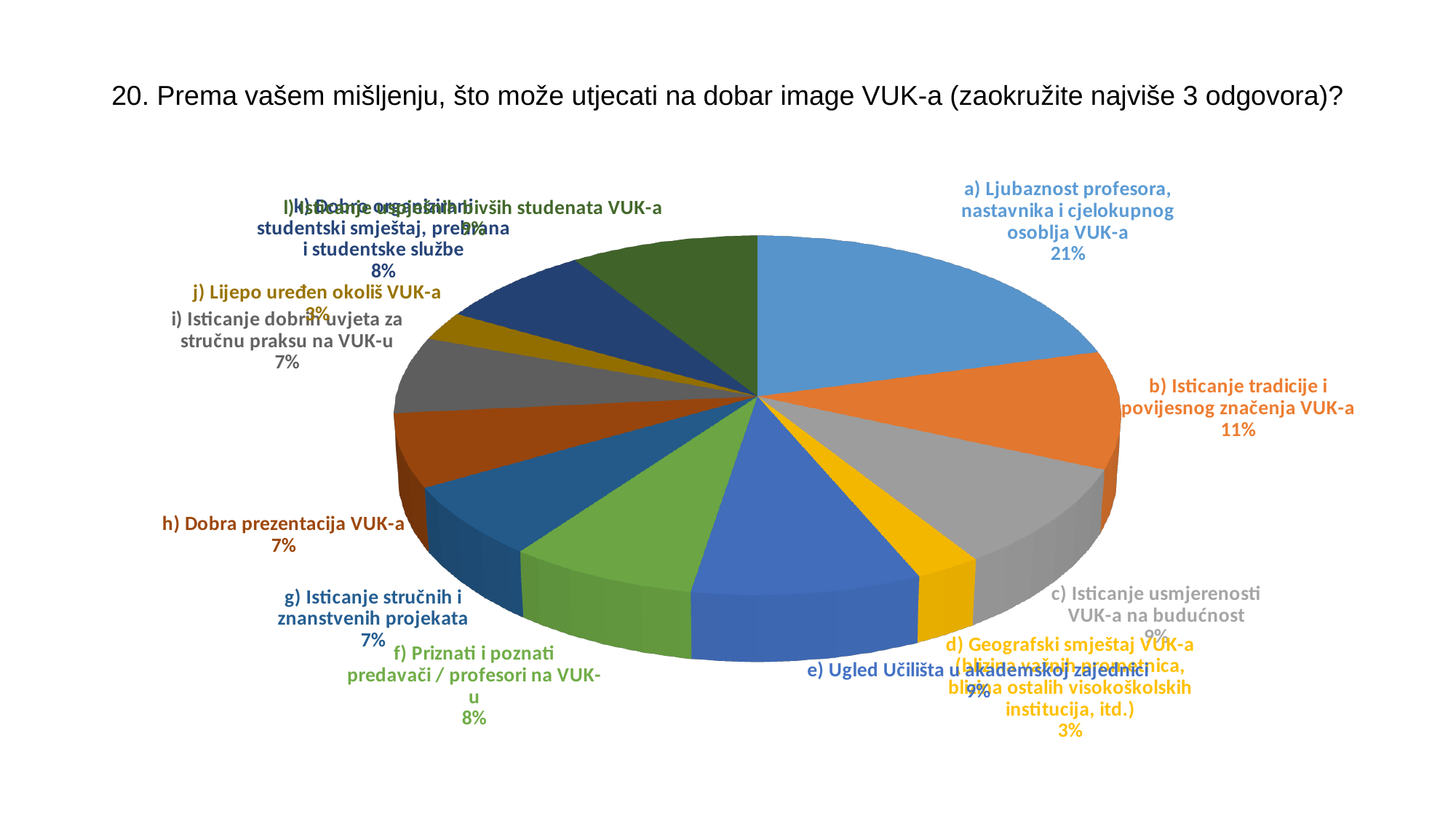
What is the value for "c) Isticanje usmjerenosti VUK-a na budućnost"? 9% What is the value for "h) Dobra prezentacija VUK-a"? 7% What is the value for "f) Priznati i poznati predavači / profesori na VUK-u"? 8% Which category has the largest share of the pie? a) Ljubaznost profesora, nastavnika i cjelokupnog osoblja VUK-a Which is larger: the share for "a) Ljubaznost profesora, nastavnika i cjelokupnog osoblja VUK-a" or for "b) Isticanje tradicije i povijesnog značenja VUK-a"? a) Ljubaznost profesora, nastavnika i cjelokupnog osoblja VUK-a What kind of chart is shown on the slide? pie chart What is the value for "b) Isticanje tradicije i povijesnog značenja VUK-a"? 11% What share of the pie does "a) Ljubaznost profesora, nastavnika i cjelokupnog osoblja VUK-a" have? 21% What is the value for "g) Isticanje stručnih i znanstvenih projekata"? 7% How many slices does the pie chart have? 12 What is the difference in percentage points between "a) Ljubaznost profesora, nastavnika i cjelokupnog osoblja VUK-a" (21%) and "b) Isticanje tradicije i povijesnog značenja VUK-a" (11%)? 10 percentage points What is the value for "j) Lijepo uređen okoliš VUK-a"? 3%